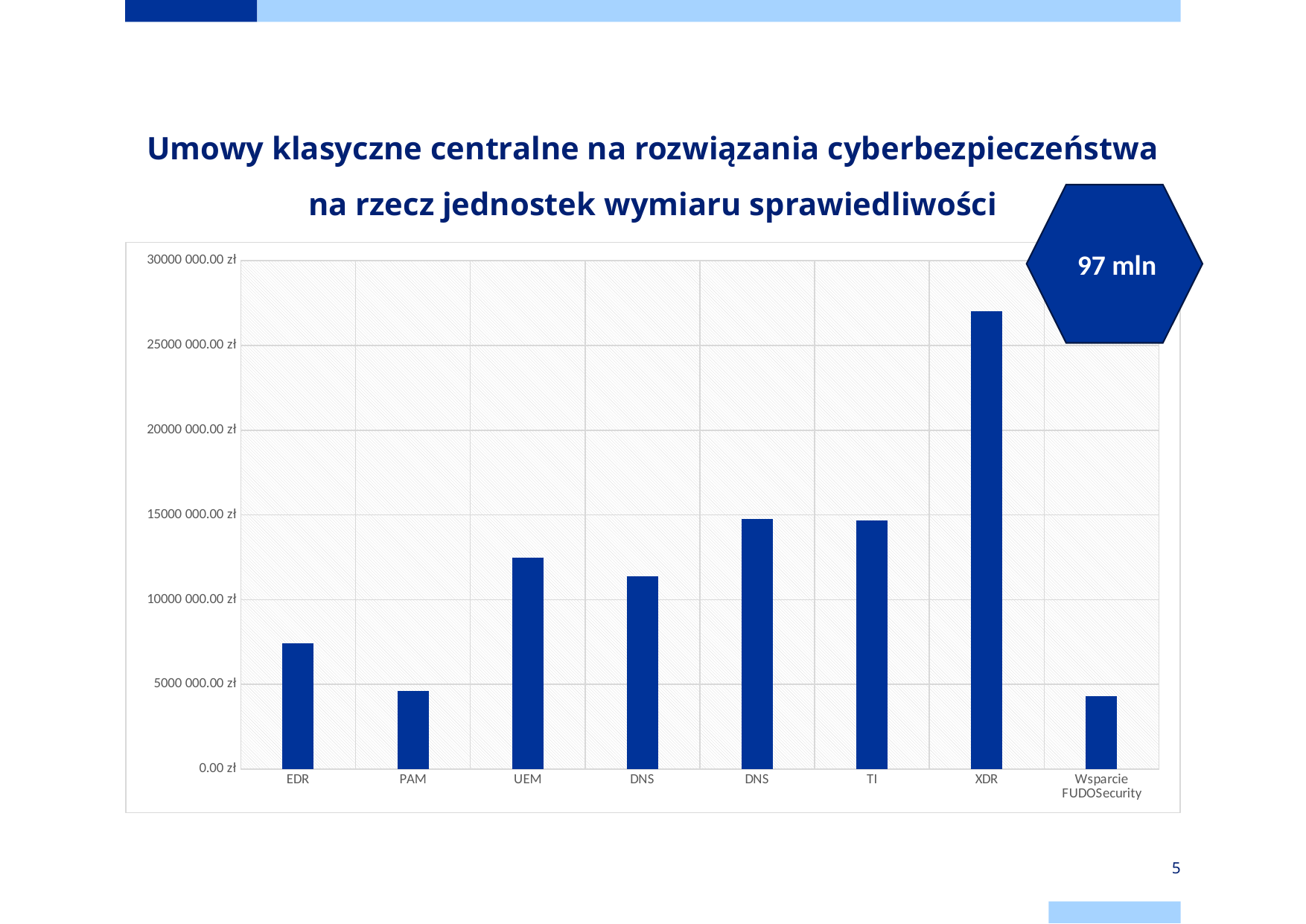
Which is larger, the value for EDR or the value for PAM? EDR Is the value for PAM greater or less than 5000 000.00 zł? less Is the value for TI greater or less than 15000 000.00 zł? less Is the value for Wsparcie FUDOSecurity greater or less than 5000 000.00 zł? less What amount is shown in the hexagon next to the chart? 97 mln How many bars (categories) are plotted in the chart? 8 What kind of chart is shown on the slide? bar chart Which category has the highest value in the chart? XDR Which is larger, the value for XDR or the value for UEM? XDR